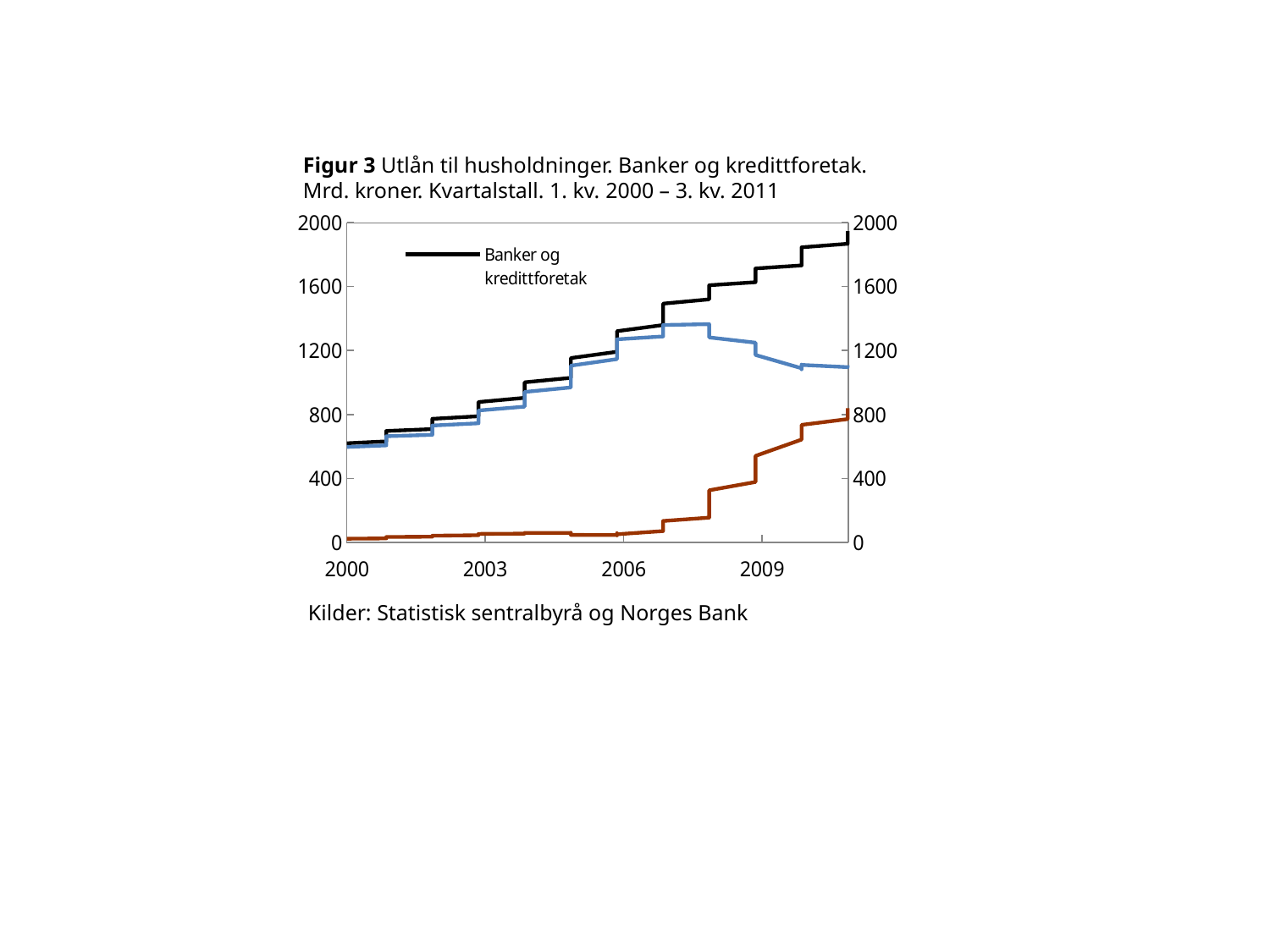
How many year labels are shown on the x axis? 4 What is the title of the chart? Figur 3 Utlån til husholdninger. Banker og kredittforetak. Mrd. kroner. Kvartalstall. 1. kv. 2000 – 3. kv. 2011 Does the Banker og kredittforetak line rise or fall from 2000 to 2011? rise Is the value for Banker og kredittforetak at the end of the period (3. kv. 2011) greater or less than 2000? less What kind of chart is shown in Figur 3? line chart Is the value for Banker og kredittforetak in 2000 greater or less than 400? greater Which of the three lines has the highest value at the end of the period? Banker og kredittforetak Which series is named in the chart's legend? Banker og kredittforetak How many series does the legend list? 1 Is the value for Banker og kredittforetak in 2000 greater or less than 800? less